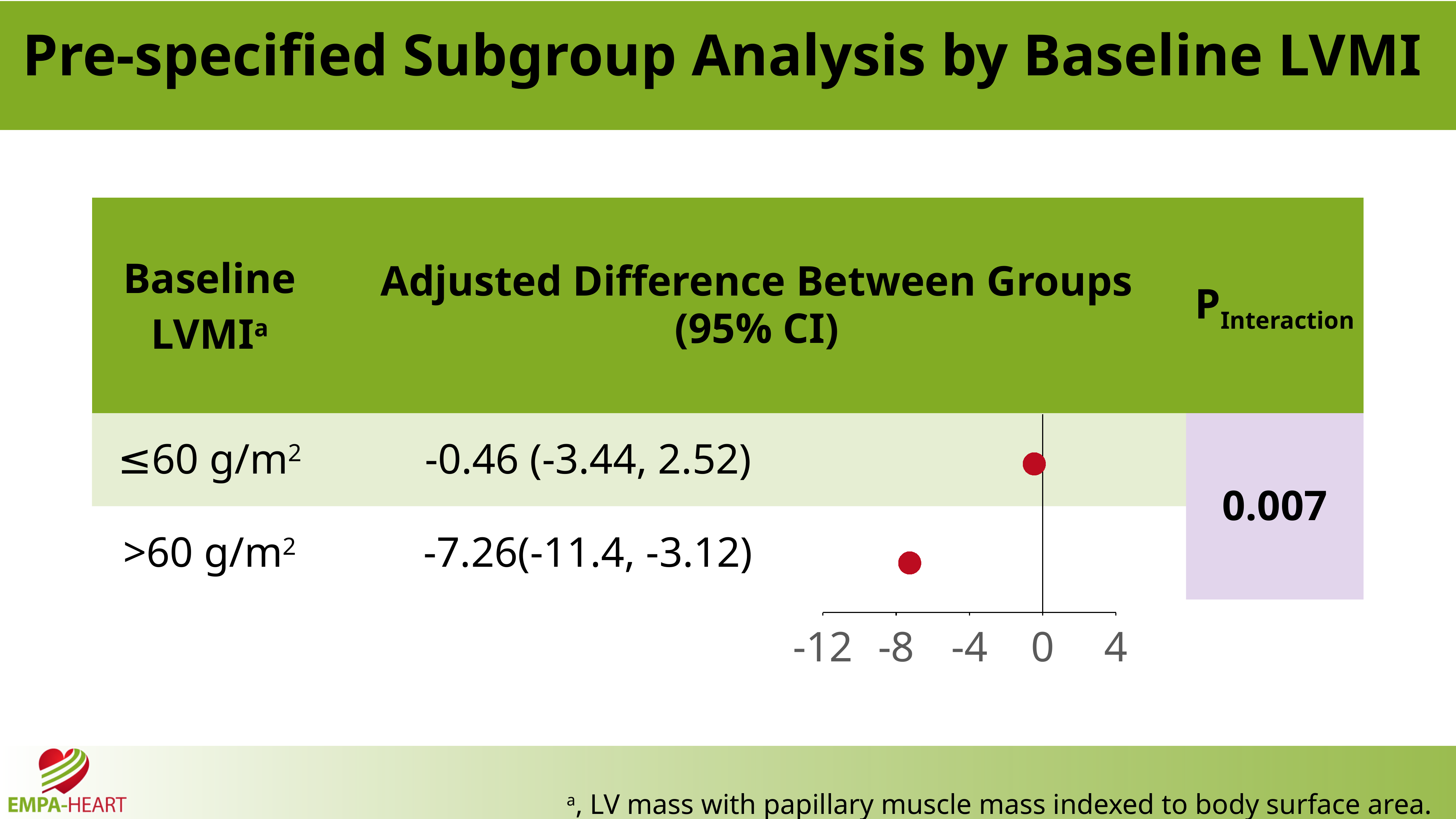
What is the P for interaction shown on the slide? 0.007 What is the 95% confidence interval for the >60 g/m² subgroup? (-11.4, -3.12) How many subgroups are plotted in the chart? 2 Which baseline LVMI subgroup has the lower adjusted difference between groups? >60 g/m² What is the 95% confidence interval for the ≤60 g/m² subgroup? (-3.44, 2.52) Is the plotted point for the >60 g/m² subgroup greater or less than -4 on the axis? less Is the plotted point for the ≤60 g/m² subgroup greater or less than -4 on the axis? greater What is the adjusted difference between groups for the >60 g/m² baseline LVMI subgroup? -7.26 What colour are the plotted points in the chart? Red Which baseline LVMI subgroup has the higher adjusted difference between groups? ≤60 g/m² What is the lowest tick value shown on the chart's horizontal axis? -12 What is the adjusted difference between groups for the ≤60 g/m² baseline LVMI subgroup? -0.46